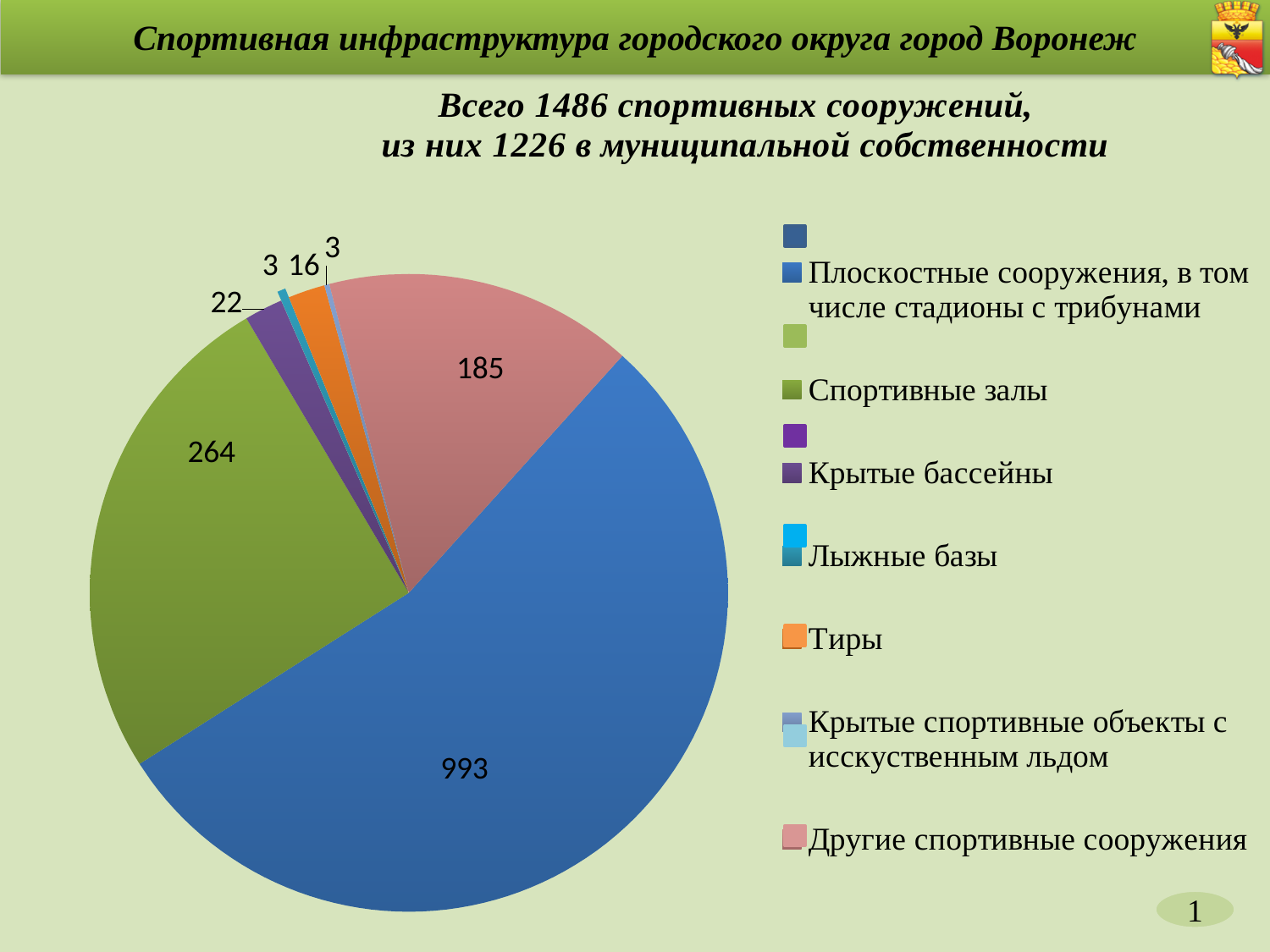
Which is larger, the value for 'Крытые бассейны' or the value for 'Тиры'? Крытые бассейны What value is shown for 'Крытые бассейны'? 22 What is the difference between the values for 'Спортивные залы' and 'Другие спортивные сооружения'? 79 What is the difference between the values for 'Плоскостные сооружения' and 'Спортивные залы'? 729 According to the slide subtitle, what is the total number of sports facilities? 1486 What value is shown for 'Тиры'? 16 Which category has the largest slice of the pie? Плоскостные сооружения, в том числе стадионы с трибунами What value is shown for 'Спортивные залы'? 264 How many slices does the pie chart have? 7 What kind of chart is shown on the slide? Pie chart What value is shown for 'Другие спортивные сооружения'? 185 How many sports facilities are in the 'Плоскостные сооружения, в том числе стадионы с трибунами' slice? 993